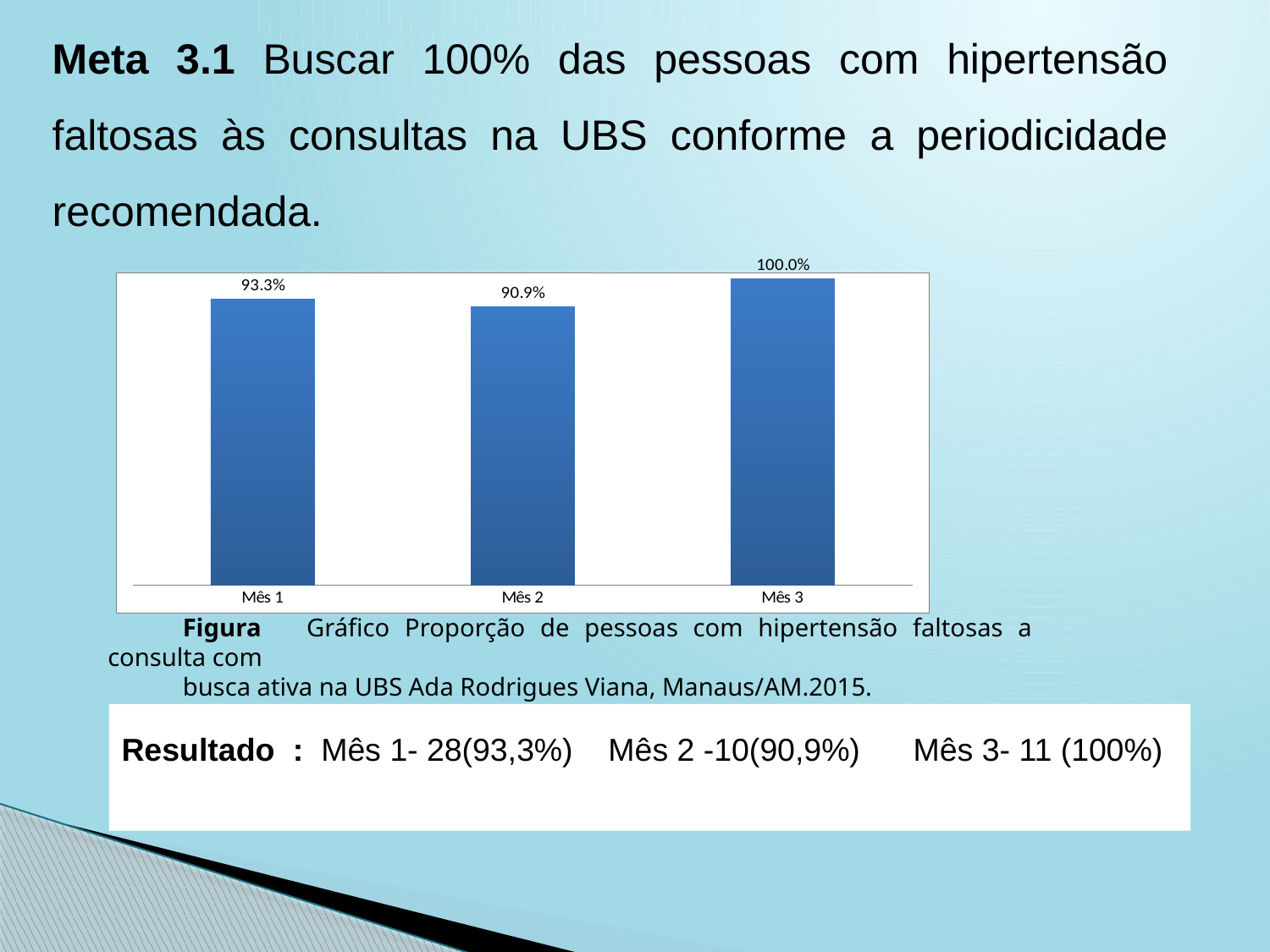
Which month has the lowest value? Mês 2 Which month has the highest value? Mês 3 What kind of chart is shown on the slide? Bar chart Which is larger, the value for Mês 1 or the value for Mês 2? Mês 1 How many categories are shown on the x axis? 3 What is the difference between the values for Mês 3 and Mês 2? 9.1% What is the difference between the values for Mês 1 and Mês 2? 2.4% What is the value for Mês 3? 100.0% What colour are the bars in the chart? Blue What is the value for Mês 1? 93.3% What is the value for Mês 2? 90.9% Does the value rise or fall from Mês 2 to Mês 3? Rise